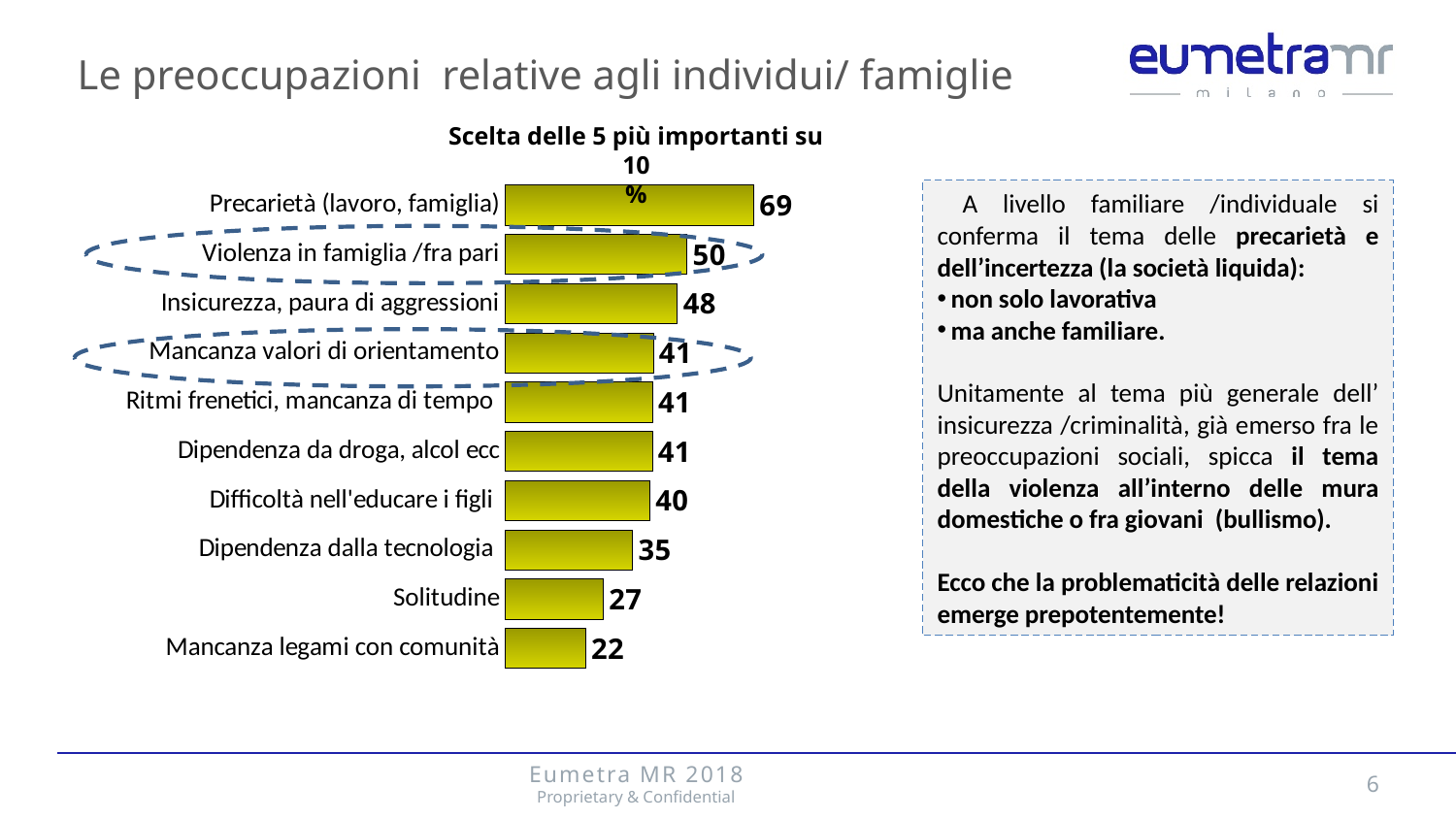
Which category has the highest value? Precarietà (lavoro, famiglia) What is the difference between the values for Solitudine and Mancanza legami con comunità? 5 Which is larger, the value for Insicurezza, paura di aggressioni or the value for Difficoltà nell'educare i figli? Insicurezza, paura di aggressioni What is the value for Mancanza legami con comunità? 22 What is the difference between the values for Precarietà (lavoro, famiglia) and Violenza in famiglia /fra pari? 19 What is the value for Dipendenza dalla tecnologia? 35 What kind of chart is shown on the slide? Bar chart What is the value for Violenza in famiglia /fra pari? 50 What is the title of the chart? Scelta delle 5 più importanti su 10 How many categories are shown in the chart? 10 Which category has the lowest value? Mancanza legami con comunità What is the value for Precarietà (lavoro, famiglia)? 69